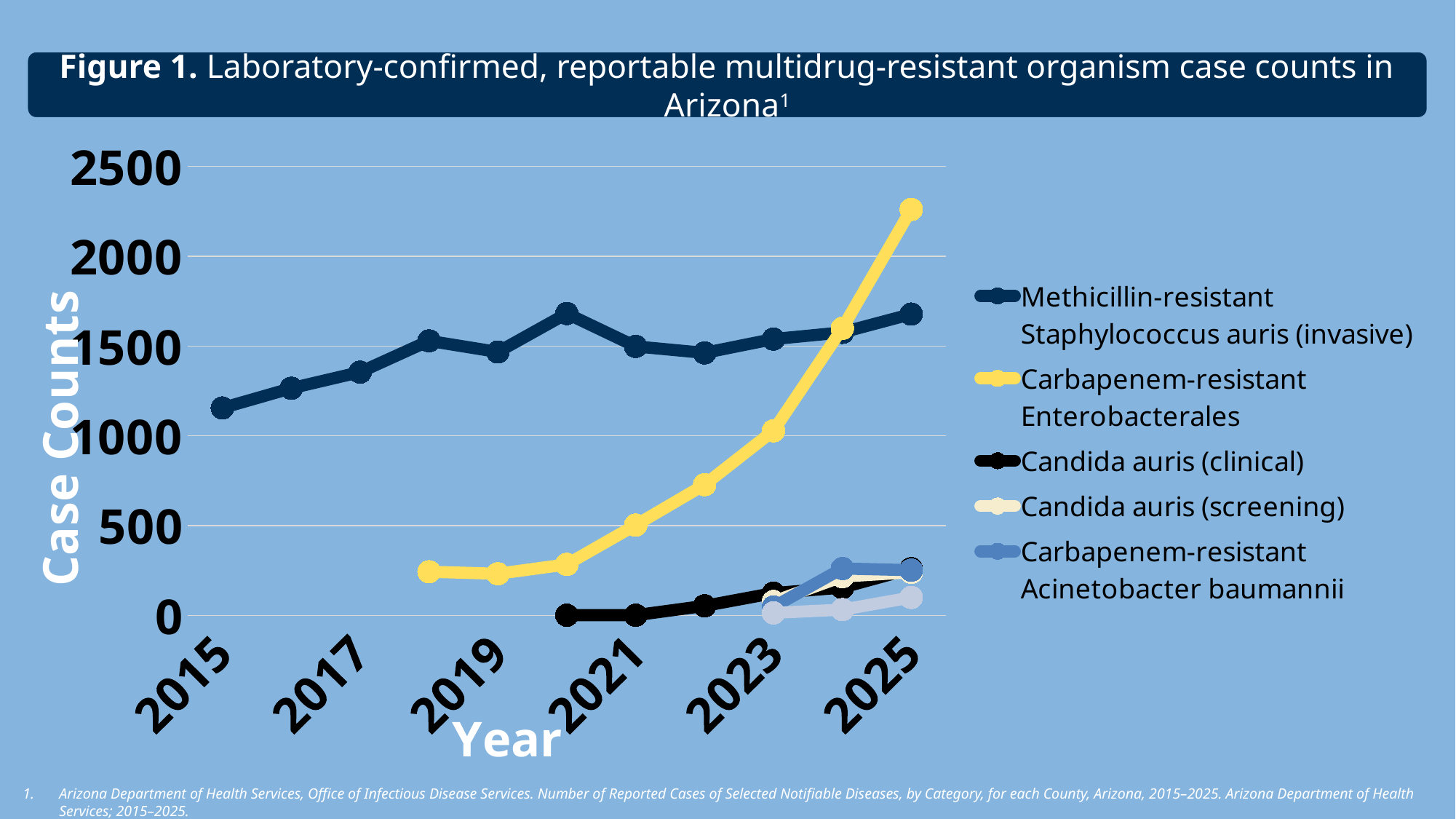
How many series does the legend list? 5 Is the value for Methicillin-resistant Staphylococcus auris (invasive) in 2015 greater or less than 1500? less Is the value for Carbapenem-resistant Enterobacterales in 2025 greater or less than 2000? greater What is the title of the y axis? Case Counts How many years are labelled on the x axis? 6 In 2023, which is larger: Methicillin-resistant Staphylococcus auris (invasive) or Carbapenem-resistant Enterobacterales? Methicillin-resistant Staphylococcus auris (invasive) Is the value for Carbapenem-resistant Enterobacterales in 2019 greater or less than 500? less Do the values for Carbapenem-resistant Enterobacterales rise or fall from 2019 to 2025? rise Which series has the highest case count in 2025? Carbapenem-resistant Enterobacterales What kind of chart is shown on the slide? line chart